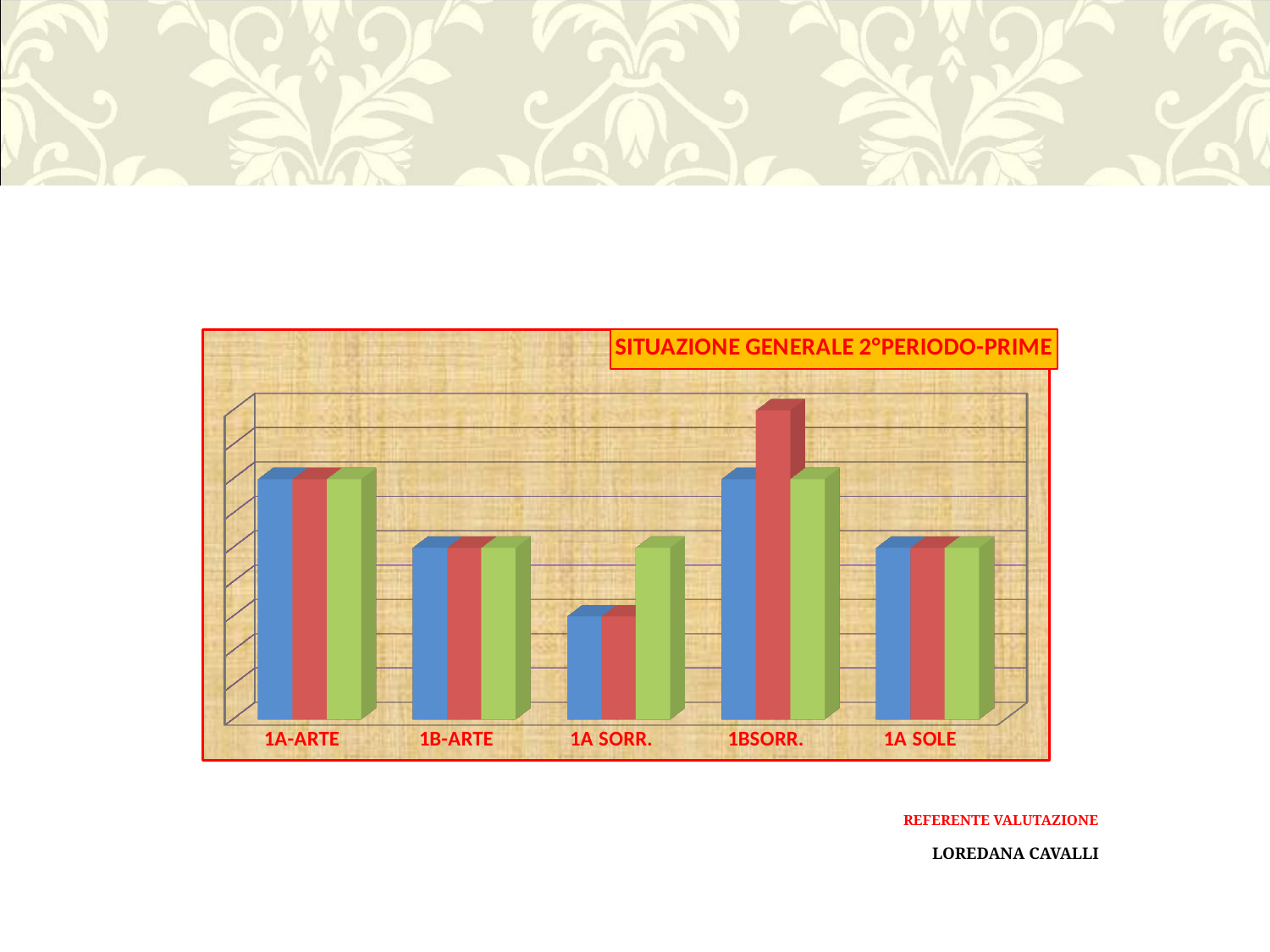
How many categories are shown on the x axis of the chart? 5 Is the green bar taller for 1BSORR. or for 1A SOLE? 1BSORR. Which category has the tallest red bar in the chart? 1BSORR. What colours are the three bars in each category of the chart? blue, red and green Which category has the shortest blue bar in the chart? 1A SORR. What is the title of the chart? SITUAZIONE GENERALE 2°PERIODO-PRIME How many bars are plotted for each category in the chart? 3 What kind of chart is shown on the slide? bar chart For 1A SORR., is the green bar or the red bar taller? green bar Is the blue bar taller for 1A SOLE or for 1A SORR.? 1A SOLE Which category has the shortest red bar in the chart? 1A SORR.